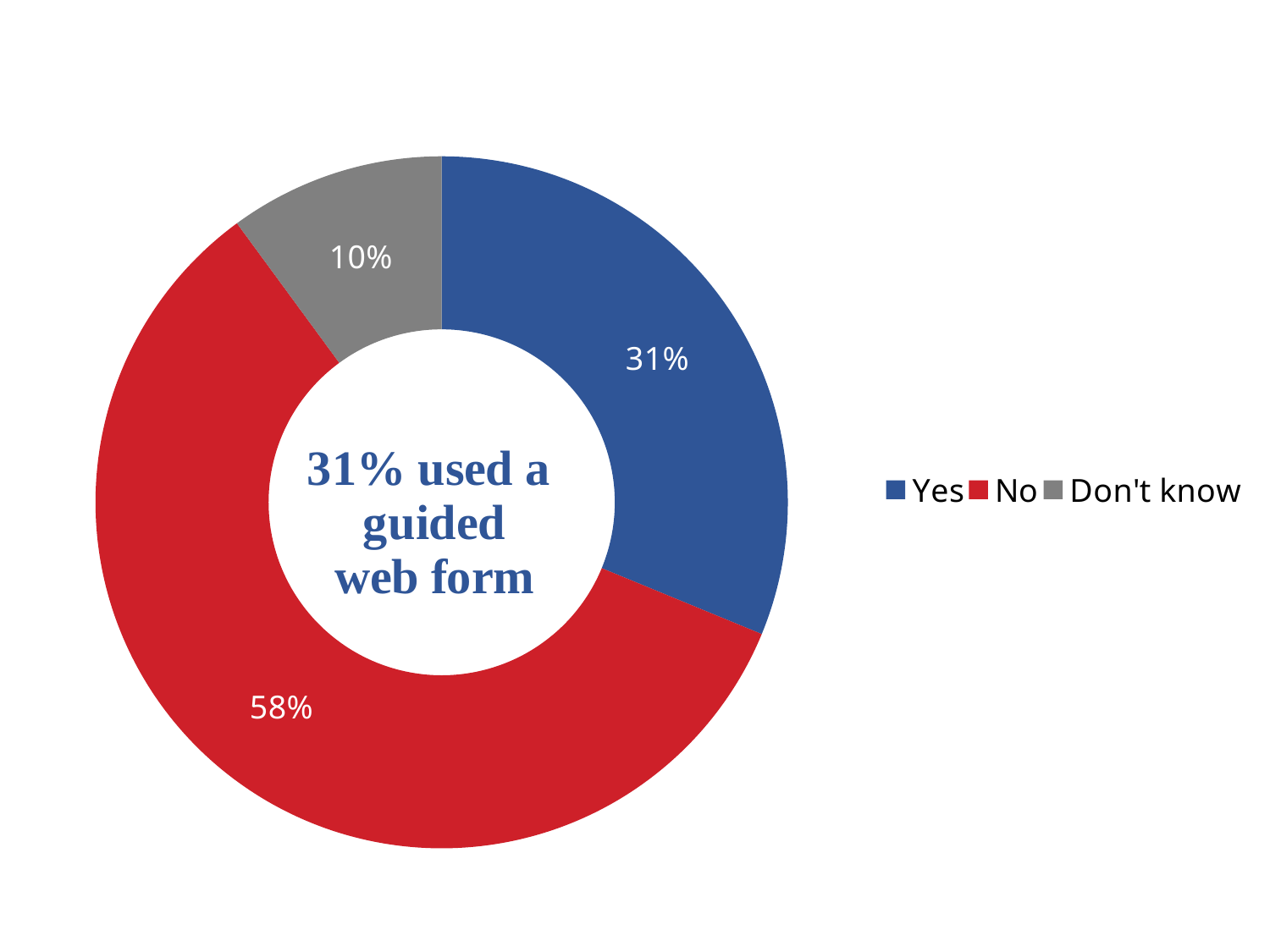
Which response has the smallest share of the chart? Don't know What percentage of respondents answered "Don't know"? 10% Which colour represents the "No" category in the legend? Red What text is written in the centre of the chart? 31% used a guided web form What is the difference in percentage points between the "No" and "Yes" shares? 27 What percentage of respondents answered "Yes"? 31% How many categories does the chart show? 3 Which response has the largest share of the chart? No What kind of chart is shown on the slide? Doughnut (pie) chart What percentage of respondents answered "No"? 58% What share of the chart does the "Yes" slice represent? 31% Which is larger, the share for "Yes" or the share for "Don't know"? Yes